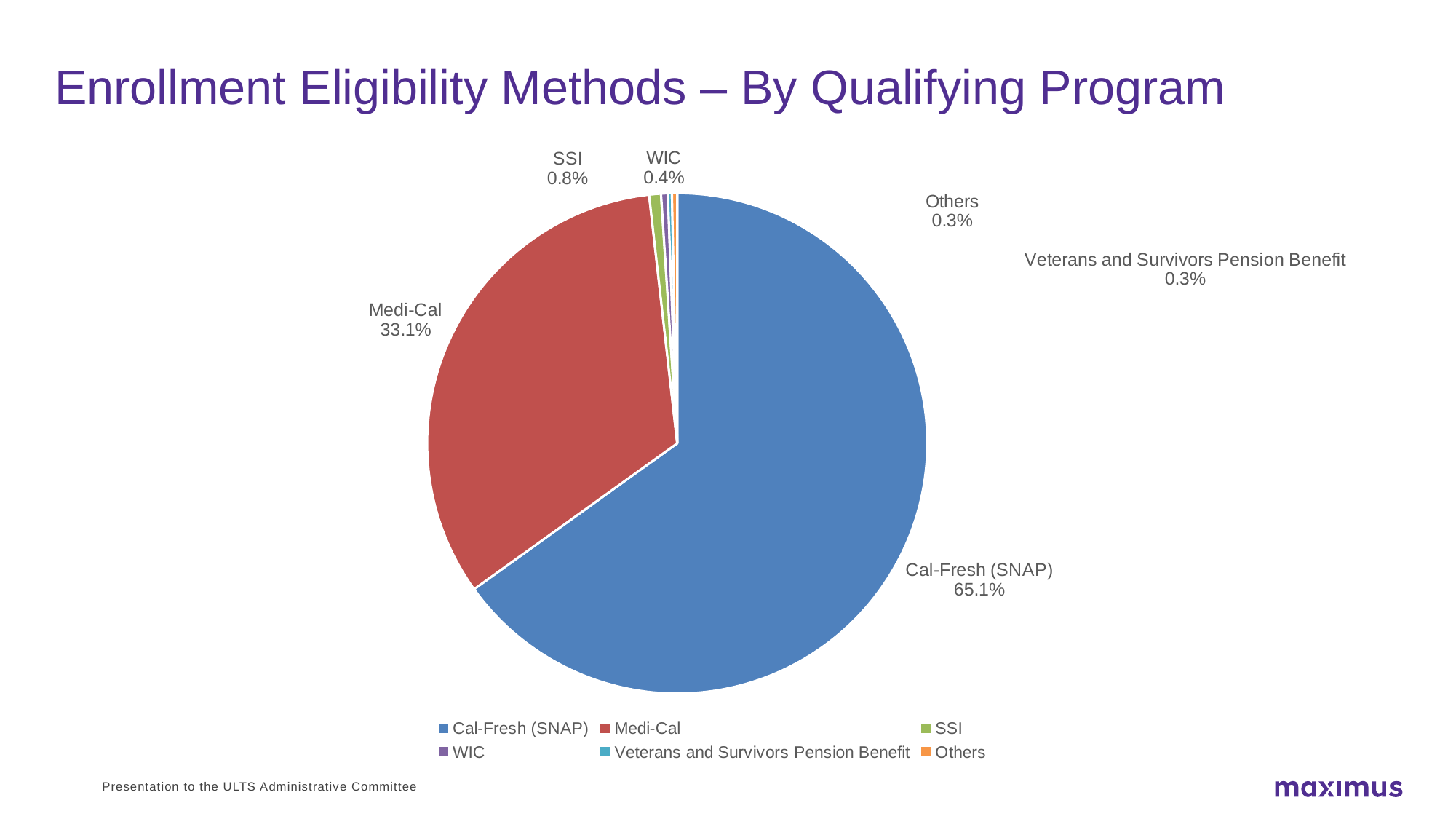
What is the value shown for SSI? 0.8% What is the value shown for Medi-Cal? 33.1% Which qualifying program has the largest slice of the pie? Cal-Fresh (SNAP) How many qualifying programs are shown in the pie chart? 6 Which is larger, the share for SSI or the share for WIC? SSI What share of the pie does Cal-Fresh (SNAP) account for? 65.1% What colour is the Medi-Cal slice in the pie chart? Red What is the value shown for WIC? 0.4% What is the title of the chart on the slide? Enrollment Eligibility Methods – By Qualifying Program What kind of chart is shown on the slide? Pie chart What is the difference in percentage points between Cal-Fresh (SNAP) and Medi-Cal? 32.0% What is the value shown for Veterans and Survivors Pension Benefit? 0.3%